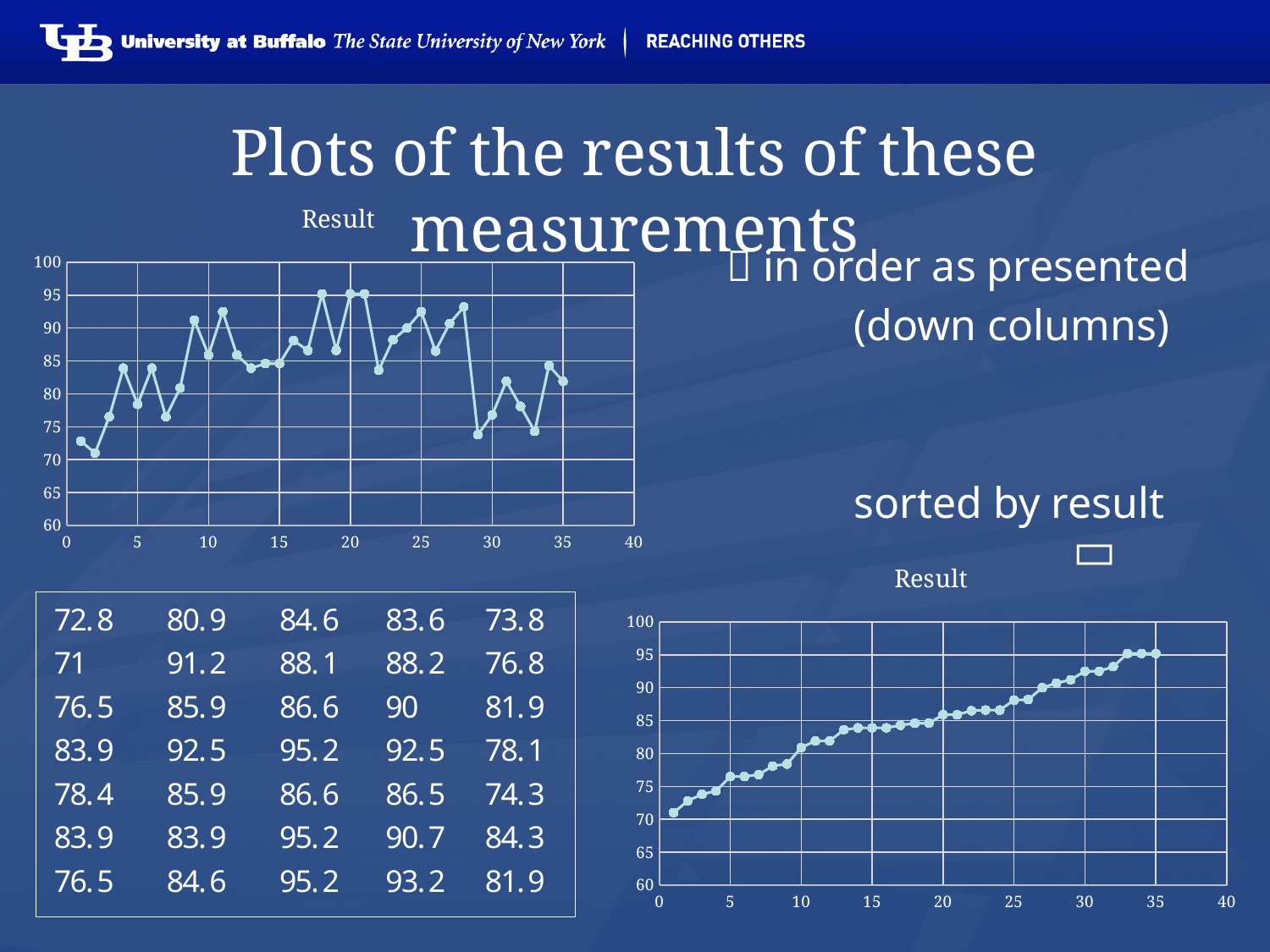
What is the lowest value shown on the y axis of the top-left chart? 60 In the top-left chart (in order as presented), is the value at x = 20 greater or less than 90? greater What title is shown above each of the two charts on the slide? Result In the bottom-right chart (sorted by result), is the value at x = 35 greater or less than 90? greater In the bottom-right chart (sorted by result), do the values rise or fall along the x axis? rise What kind of chart is the bottom-right chart titled "Result"? line chart In the top-left chart (in order as presented), is the value at x = 11 greater or less than 90? greater What kind of chart is the top-left chart titled "Result"? line chart In the top-left chart (in order as presented), which is larger, the value at x = 2 or the value at x = 20? x = 20 How many data points are plotted in the bottom-right chart (sorted by result)? 35